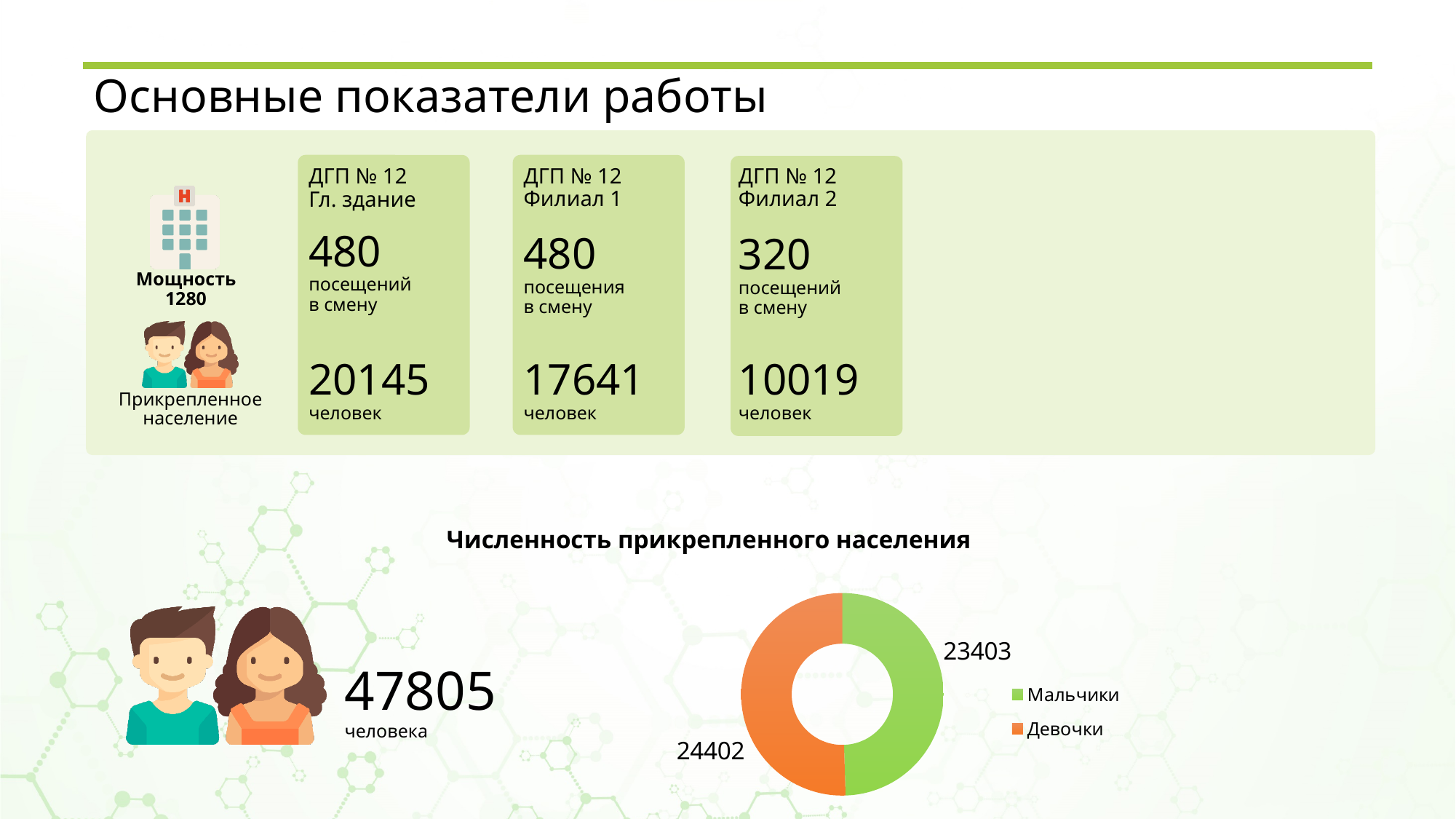
What is the difference between the values for Девочки and Мальчики in the chart? 999 Which category has the largest value in the chart? Девочки How many entries does the chart's legend list? 2 Which colour represents Девочки in the chart? orange How many categories does the chart show? 2 What kind of chart is shown under the title "Численность прикрепленного населения"? doughnut chart What is the total of the two values shown in the chart? 47805 Which category has the smallest value in the chart? Мальчики What is the value for Мальчики in the chart? 23403 What is the value for Девочки in the chart? 24402 What is the title of the chart? Численность прикрепленного населения Which category has the larger value in the chart, Мальчики or Девочки? Девочки